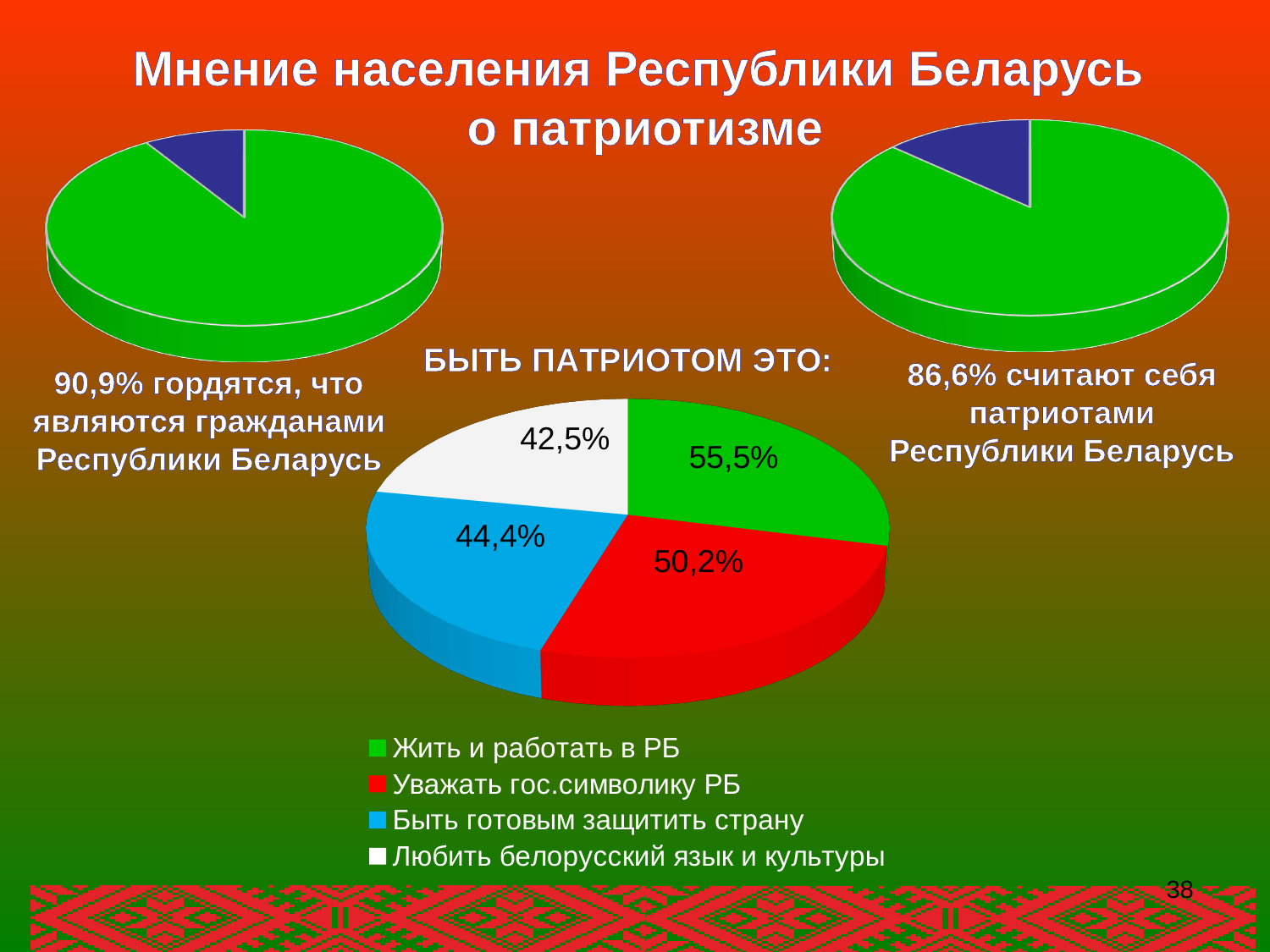
What kind of chart is the centre chart titled "БЫТЬ ПАТРИОТОМ ЭТО:"? Pie chart In the centre pie chart titled "БЫТЬ ПАТРИОТОМ ЭТО:", what is the value for "Жить и работать в РБ"? 55,5% In the centre pie chart titled "БЫТЬ ПАТРИОТОМ ЭТО:", which category has the highest value? Жить и работать в РБ In the centre pie chart titled "БЫТЬ ПАТРИОТОМ ЭТО:", what is the value for "Быть готовым защитить страну"? 44,4% How many categories does the legend of the centre pie chart titled "БЫТЬ ПАТРИОТОМ ЭТО:" list? 4 In the centre pie chart titled "БЫТЬ ПАТРИОТОМ ЭТО:", what colour is the slice for "Быть готовым защитить страну"? Blue In the centre pie chart titled "БЫТЬ ПАТРИОТОМ ЭТО:", what is the difference between "Жить и работать в РБ" and "Уважать гос.символику РБ"? 5,3% In the centre pie chart titled "БЫТЬ ПАТРИОТОМ ЭТО:", what is the value for "Любить белорусский язык и культуры"? 42,5% In the centre pie chart titled "БЫТЬ ПАТРИОТОМ ЭТО:", which is larger: "Быть готовым защитить страну" or "Уважать гос.символику РБ"? Уважать гос.символику РБ In the centre pie chart titled "БЫТЬ ПАТРИОТОМ ЭТО:", which category has the lowest value? Любить белорусский язык и культуры How many pie charts are shown on the slide? 3 In the centre pie chart titled "БЫТЬ ПАТРИОТОМ ЭТО:", what is the value for "Уважать гос.символику РБ"? 50,2%